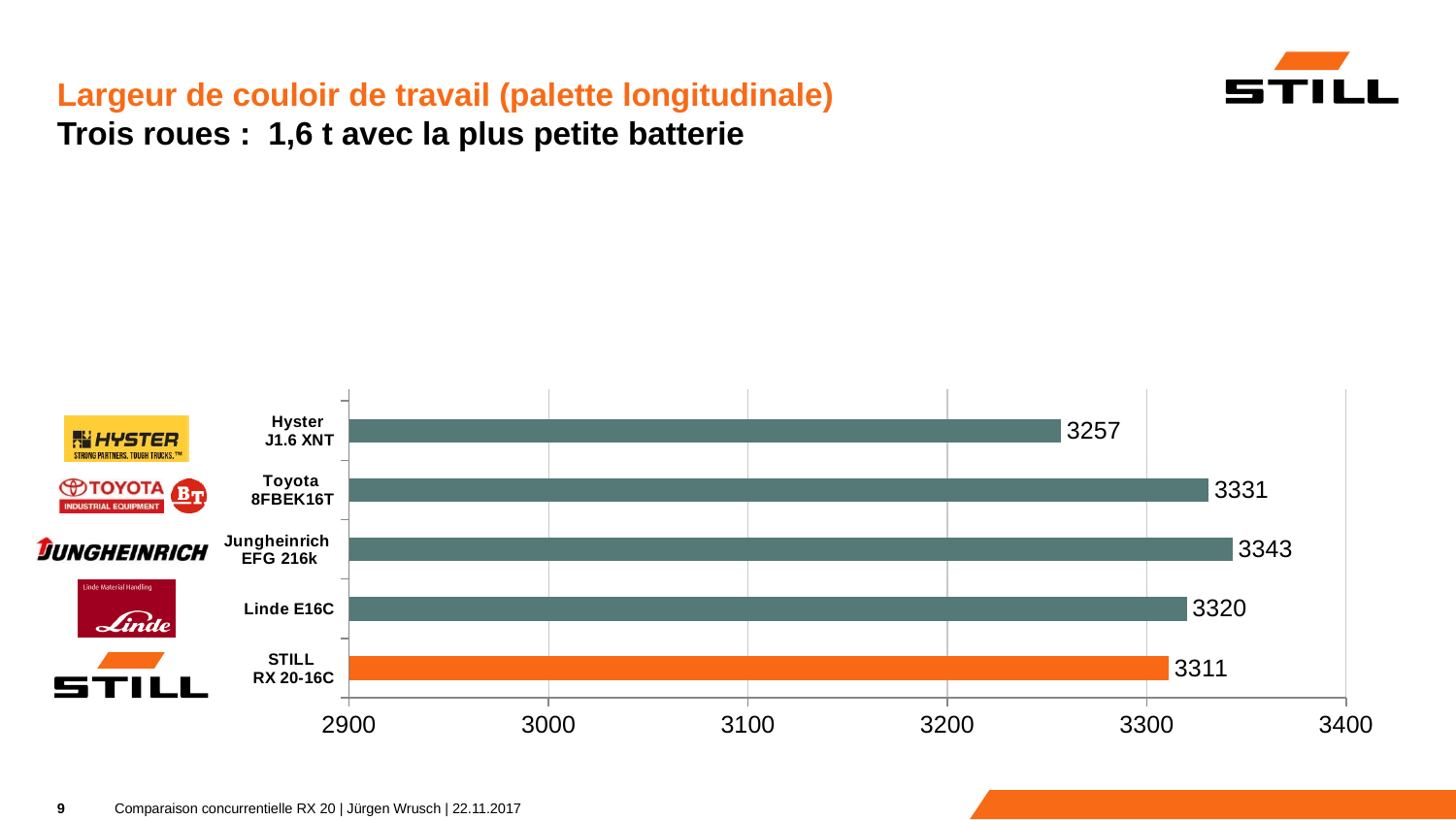
What is the difference between the values for Toyota 8FBEK16T and STILL RX 20-16C? 20 What is the value for Linde E16C? 3320 Which category has the highest value? Jungheinrich EFG 216k Which category has the lowest value? Hyster J1.6 XNT How many categories are shown in the chart? 5 What kind of chart is shown on the slide? bar chart What is the value for STILL RX 20-16C? 3311 What is the value for Hyster J1.6 XNT? 3257 Which is larger, the value for Linde E16C or the value for Toyota 8FBEK16T? Toyota 8FBEK16T Which bar is coloured orange rather than grey-green? STILL RX 20-16C Is the value for Hyster J1.6 XNT greater or less than 3300? less What is the value for Jungheinrich EFG 216k? 3343